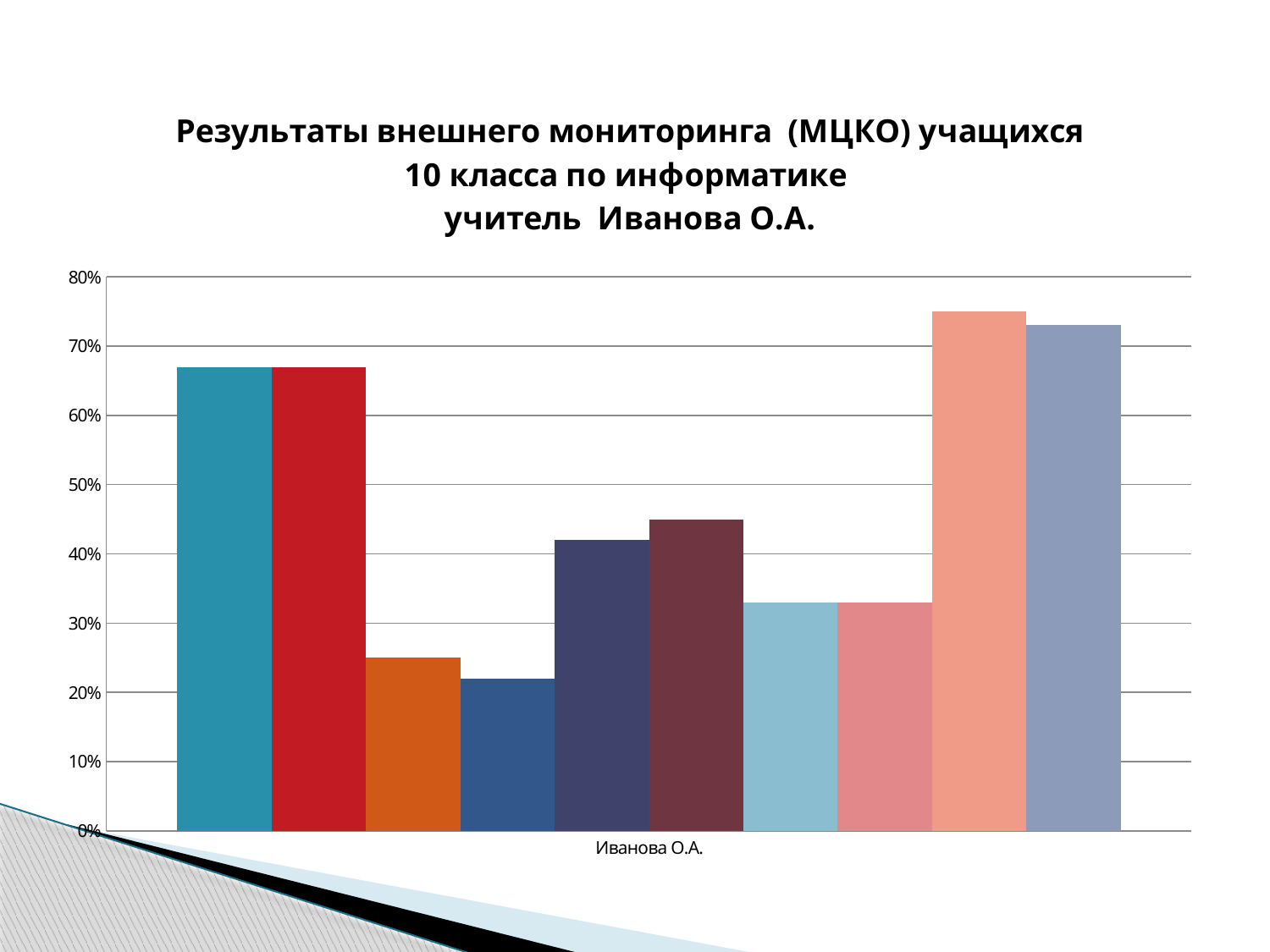
Is the value of the fourth (blue) bar from the left greater or less than 30%? less What is the category label shown under the bars on the x axis? Иванова О.А. Is the value of the sixth (dark maroon) bar from the left greater or less than 50%? less Is the value of the third (orange) bar from the left greater or less than 30%? less What kind of chart is shown on the slide? bar chart Which is taller, the fifth (dark navy) bar or the seventh (light blue) bar? the fifth (dark navy) bar Which is taller, the tenth (grey-blue) bar or the eighth (pink) bar? the tenth (grey-blue) bar How many bars are plotted in the chart? 10 Which is taller, the first (teal) bar or the third (orange) bar? the first (teal) bar What is the highest value shown on the vertical axis of the chart? 80%